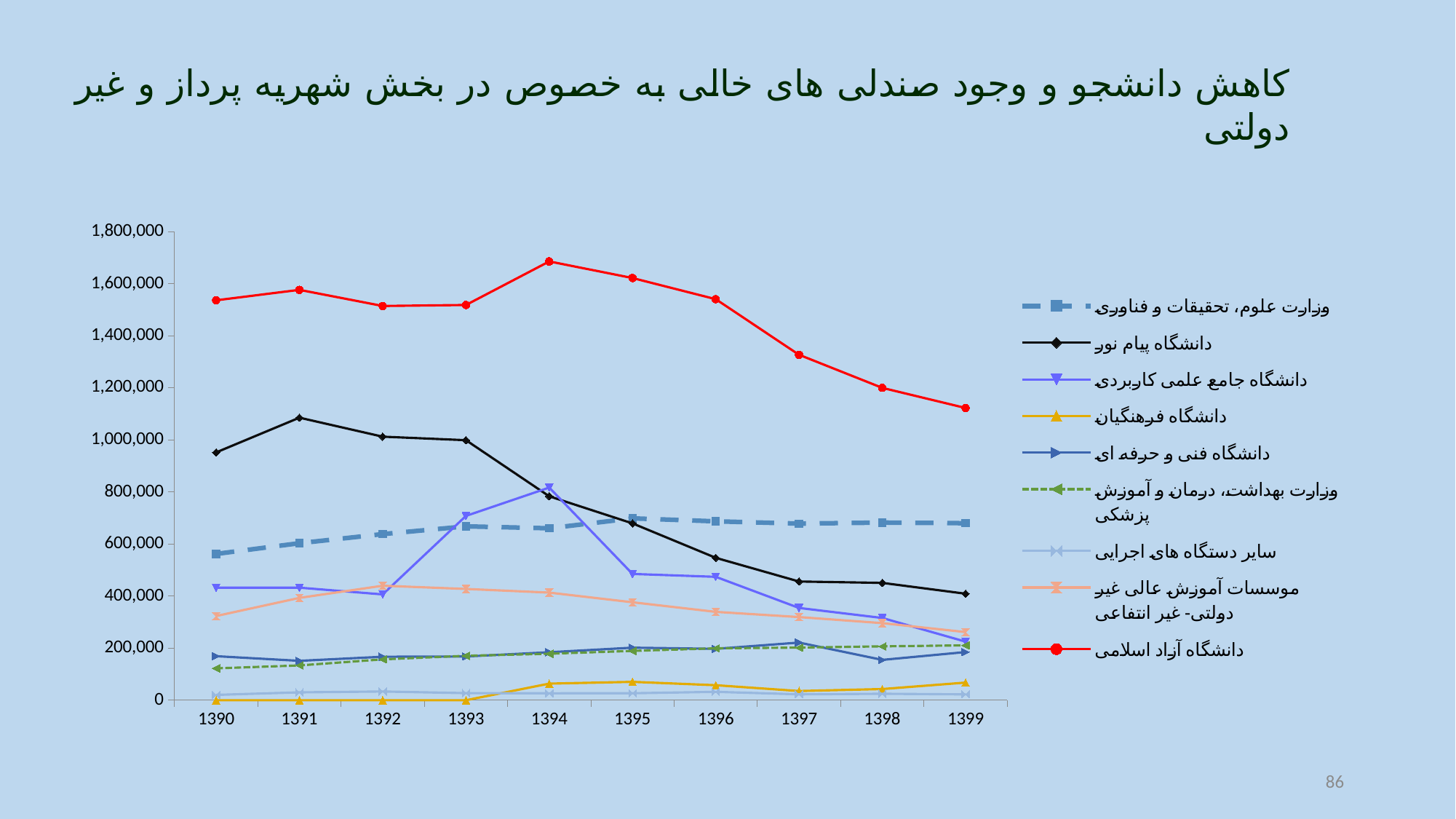
How many years are shown on the x axis? 10 Does the دانشگاه آزاد اسلامی series rise or fall from 1394 to 1399? fall What kind of chart is shown on the slide? line chart Is the value for دانشگاه جامع علمی کاربردی in 1394 greater or less than 600,000? greater Is the value for دانشگاه آزاد اسلامی in 1399 greater or less than 1,000,000? greater How many series does the legend list? 9 In 1399, which is larger: وزارت علوم، تحقیقات و فناوری or دانشگاه پیام نور? وزارت علوم، تحقیقات و فناوری Which series has the lowest value in 1390? دانشگاه فرهنگیان What colour is the line for دانشگاه آزاد اسلامی? red In which year does the دانشگاه آزاد اسلامی series reach its highest value? 1394 Which series has the highest value in 1394? دانشگاه آزاد اسلامی Is the value for دانشگاه آزاد اسلامی in 1394 greater or less than 1,600,000? greater